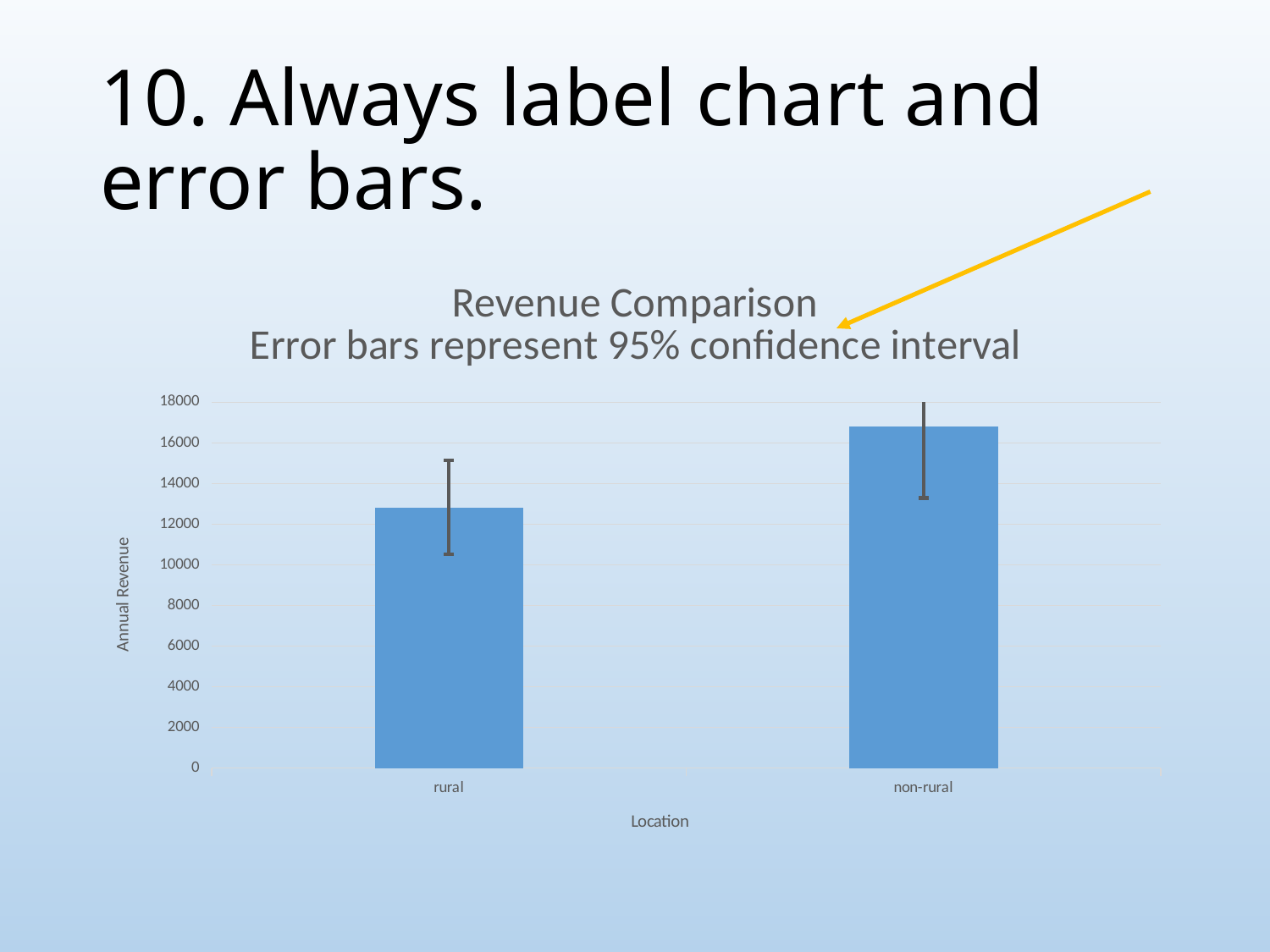
How many categories are plotted on the x axis of the chart? 2 According to the chart subtitle, what do the error bars represent? 95% confidence interval Which location has the highest annual revenue in the chart? non-rural Is the value for non-rural greater or less than 16000? greater What kind of chart is shown on the slide? bar chart Which is larger, the annual revenue for rural or for non-rural? non-rural What is the title of the chart? Revenue Comparison Is the value for non-rural greater or less than 18000? less Which location has the lowest annual revenue in the chart? rural Is the value for rural greater or less than 14000? less